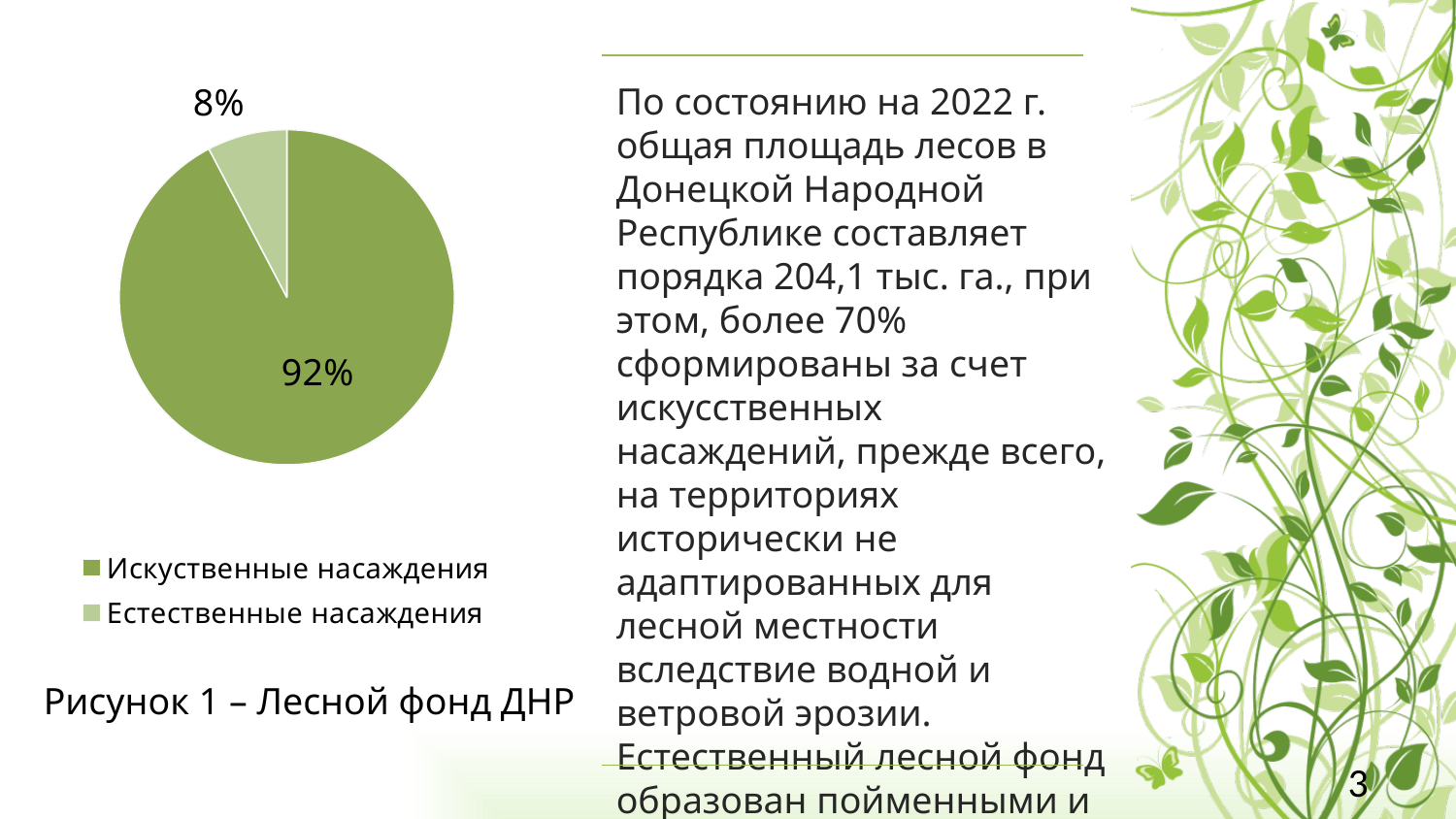
How many entries does the legend list? 2 What share of the pie does Искуственные насаждения have? 92% What share of the pie does Естественные насаждения have? 8% What is the caption of the chart? Рисунок 1 – Лесной фонд ДНР Which category has the smallest slice of the pie? Естественные насаждения What kind of chart is shown on the slide? pie chart Which is larger: Искуственные насаждения or Естественные насаждения? Искуственные насаждения Which legend entry is shown in the lighter green colour? Естественные насаждения What is the difference in percentage points between Искуственные насаждения and Естественные насаждения? 84 How many slices does the pie chart have? 2 Which category has the largest slice of the pie? Искуственные насаждения